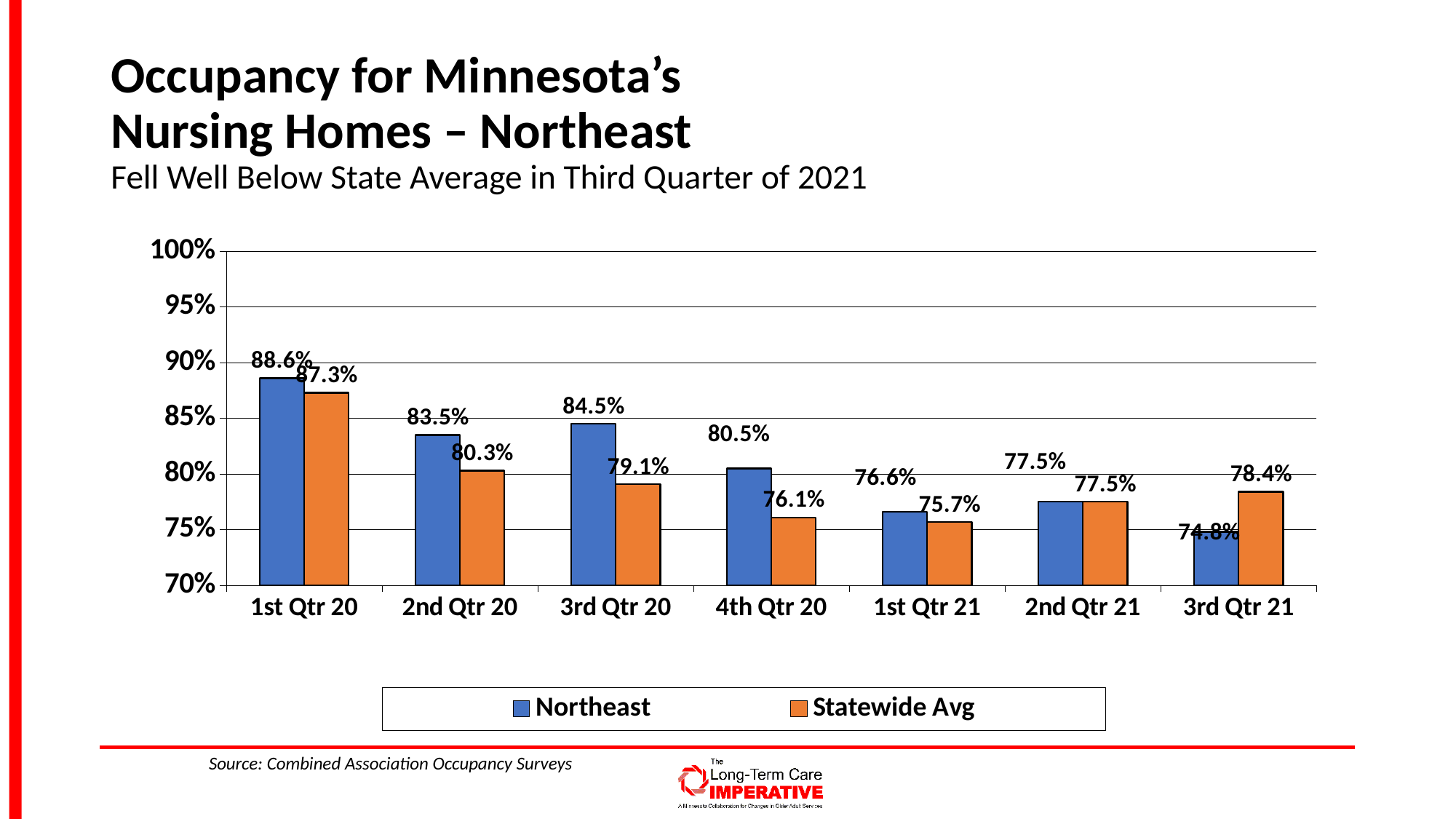
What is the difference between the Northeast and Statewide Avg values in 3rd Qtr 20? 5.4% In which quarter is the Northeast occupancy highest? 1st Qtr 20 What is the Northeast occupancy value for 1st Qtr 20? 88.6% How many series does the legend list? 2 What is the Statewide Avg occupancy value for 3rd Qtr 21? 78.4% Which colour represents the Northeast series? Blue What is the Statewide Avg occupancy value for 2nd Qtr 20? 80.3% What is the Northeast occupancy value for 4th Qtr 20? 80.5% How many quarters are shown on the x axis? 7 What kind of chart is shown on the slide? Bar chart Which is larger in 3rd Qtr 21, the Northeast value or the Statewide Avg value? Statewide Avg In which quarter is the Statewide Avg occupancy lowest? 1st Qtr 21